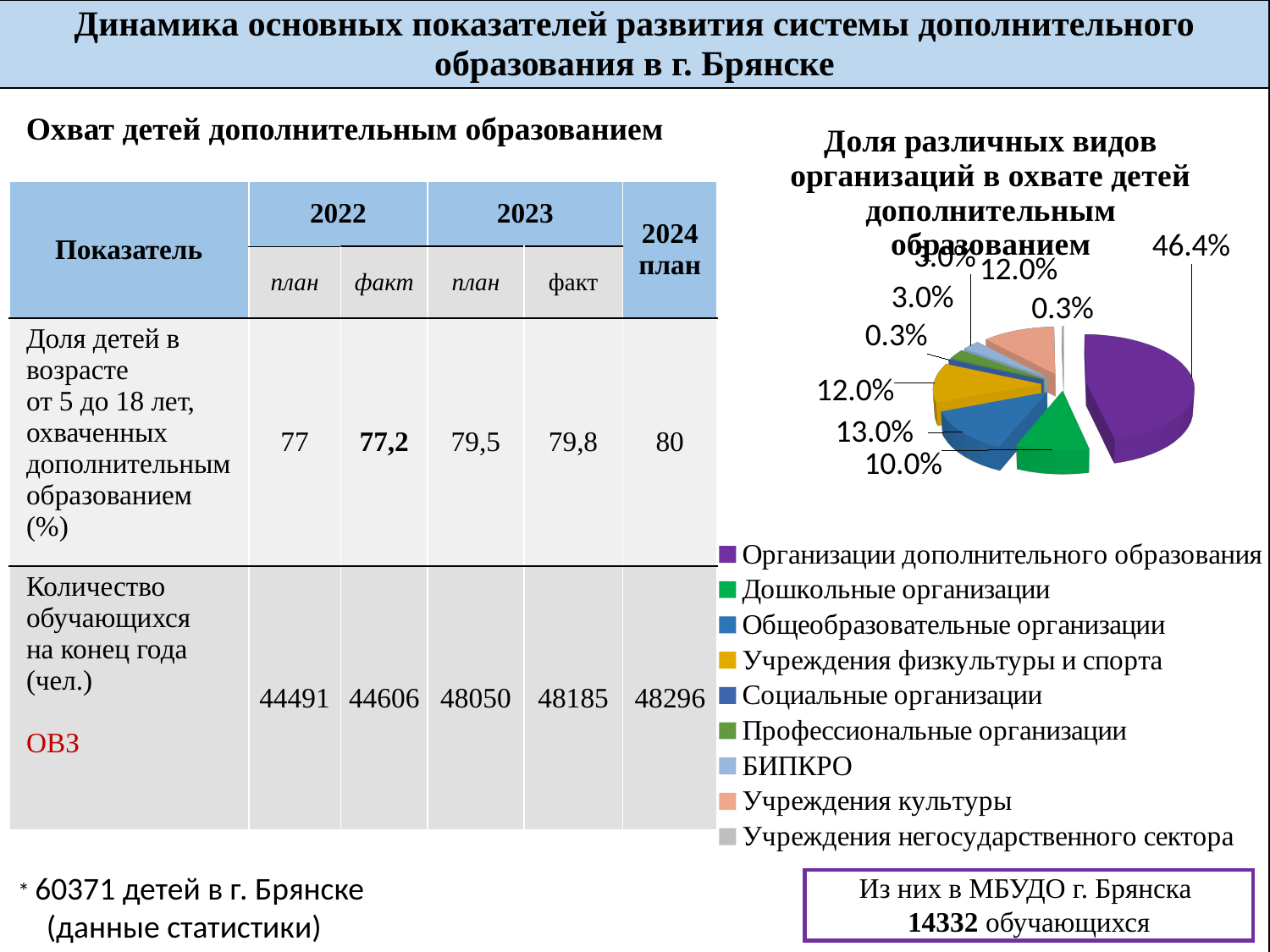
How many categories does the legend of the pie chart list? 9 What kind of chart is shown on the slide? pie chart What share of the pie chart belongs to Общеобразовательные организации? 13.0% What is the difference between the shares of Организации дополнительного образования and Дошкольные организации in the pie chart? 36.4% What share of the pie chart belongs to Учреждения культуры? 12.0% What is the title of the pie chart? Доля различных видов организаций в охвате детей дополнительным образованием What share of the pie chart belongs to Учреждения физкультуры и спорта? 12.0% What share of the pie chart belongs to Дошкольные организации? 10.0% Which is larger in the pie chart: Общеобразовательные организации or Дошкольные организации? Общеобразовательные организации What colour is the slice for Организации дополнительного образования in the pie chart? purple Which category has the largest share in the pie chart? Организации дополнительного образования What share of the pie chart belongs to Организации дополнительного образования? 46.4%